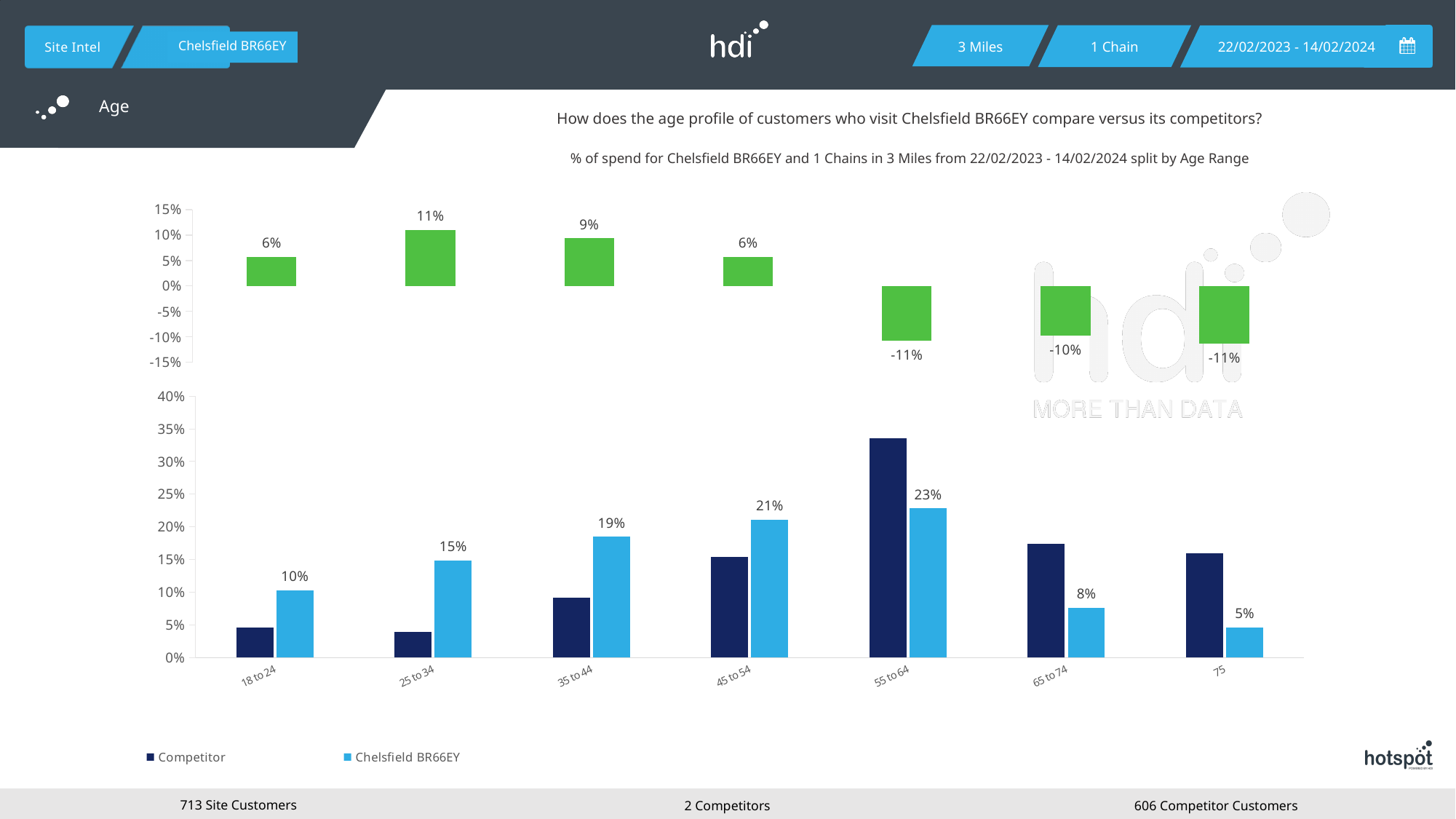
In the top chart, what is the value shown for the 65 to 74 age range? -10% In the bottom chart, what is the difference between the Chelsfield BR66EY values for 55 to 64 and 65 to 74? 15% In the bottom chart, is the Competitor value for 55 to 64 greater or less than 30%? greater In the top chart, what is the value shown for the 25 to 34 age range? 11% What kind of chart is the bottom chart? Bar chart In the bottom chart, which age range has the lowest value for Chelsfield BR66EY? 75 In the bottom chart, what is the value for Chelsfield BR66EY in the 45 to 54 age range? 21% How many age range categories are shown on the x axis of the bottom chart? 7 In the bottom chart, what is the value for Chelsfield BR66EY in the 18 to 24 age range? 10% In the bottom chart, which is larger for the 35 to 44 age range: the Competitor bar or the Chelsfield BR66EY bar? Chelsfield BR66EY How many series does the legend of the bottom chart list? 2 In the bottom chart, which age range has the highest value for Chelsfield BR66EY? 55 to 64